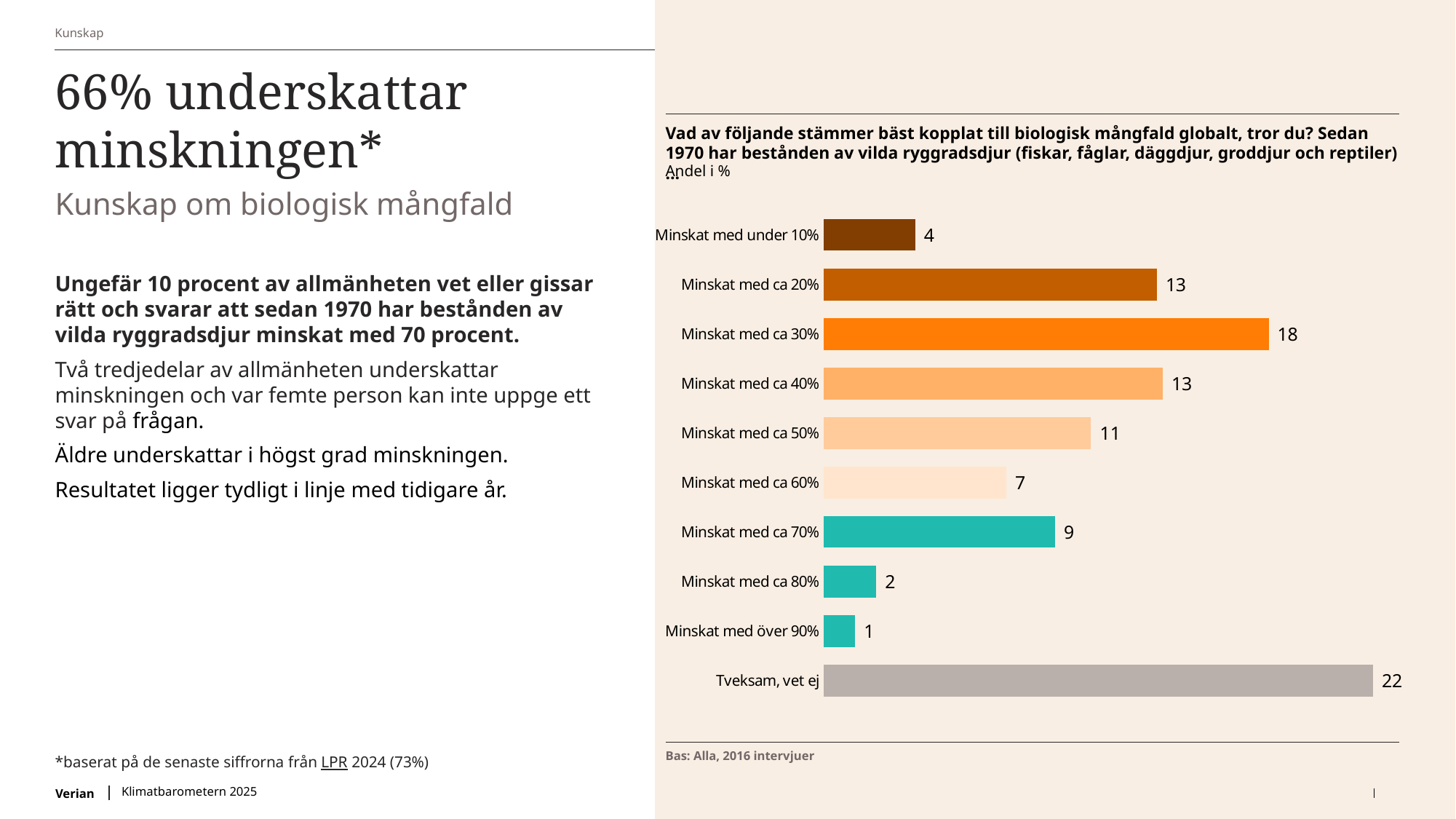
How many categories are shown in the chart? 10 What is the value for "Minskat med ca 30%"? 18 What colour is the bar for "Tveksam, vet ej"? Grey What is the value for "Minskat med ca 70%"? 9 Which category has the highest value? Tveksam, vet ej What is the value for "Minskat med under 10%"? 4 Which is larger, the value for "Minskat med ca 50%" or the value for "Minskat med ca 60%"? Minskat med ca 50% Which category has the lowest value? Minskat med över 90% What is the difference between the values for "Minskat med ca 30%" and "Minskat med ca 70%"? 9 What is the value for "Tveksam, vet ej"? 22 What kind of chart is shown on the slide? Bar chart What is the difference between the values for "Tveksam, vet ej" and "Minskat med ca 20%"? 9